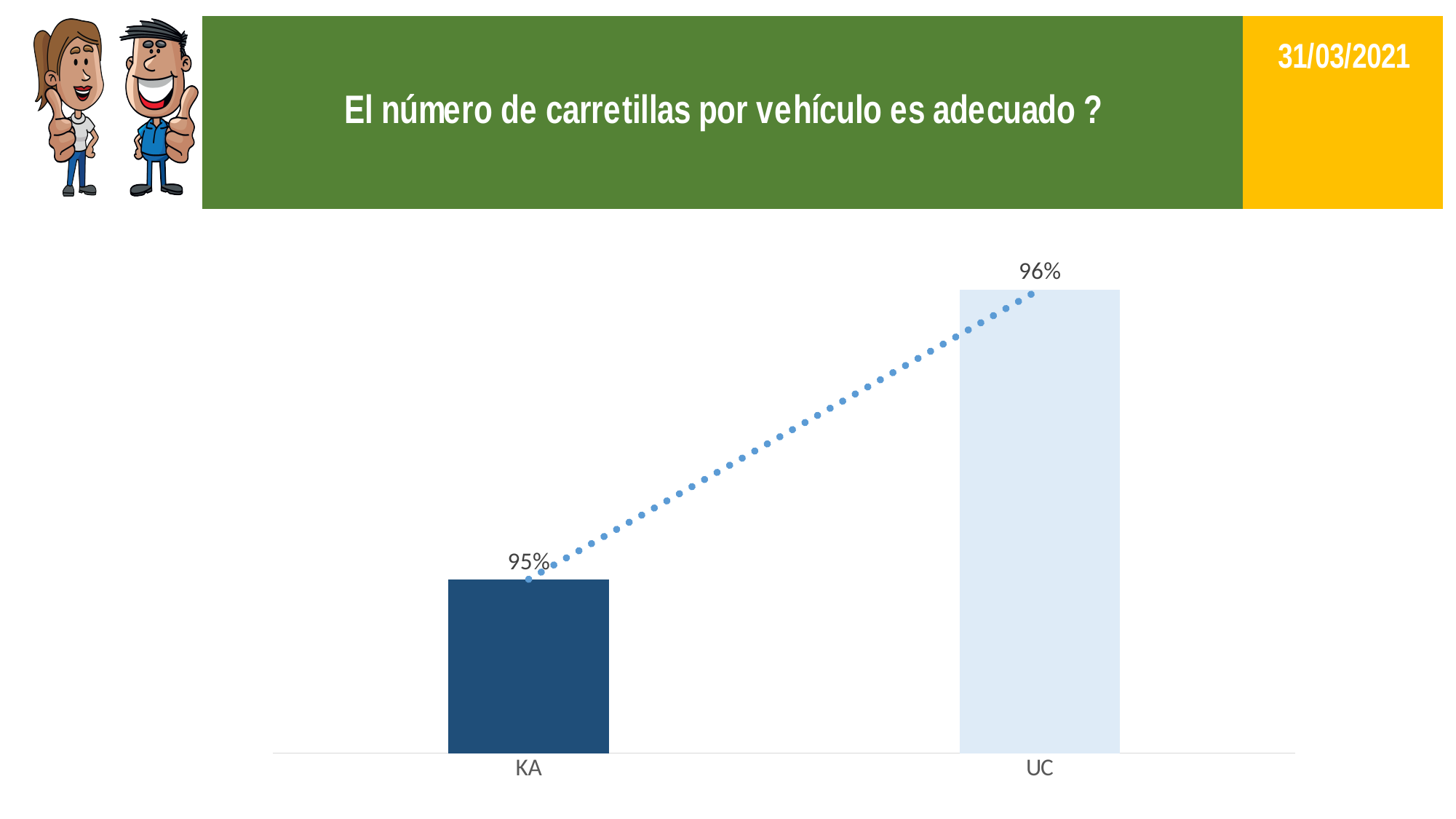
Which category has the highest value? UC What kind of chart is shown on the slide? Bar chart What is the value for KA? 95% How many categories are shown on the x axis? 2 Do the values rise or fall from KA to UC? Rise What is the difference between the values for UC and KA? 1% What date is shown on the slide? 31/03/2021 Which category has the lowest value? KA What is the value for UC? 96% What is the title shown above the chart? El número de carretillas por vehículo es adecuado ? Which is larger, the value for KA or the value for UC? UC